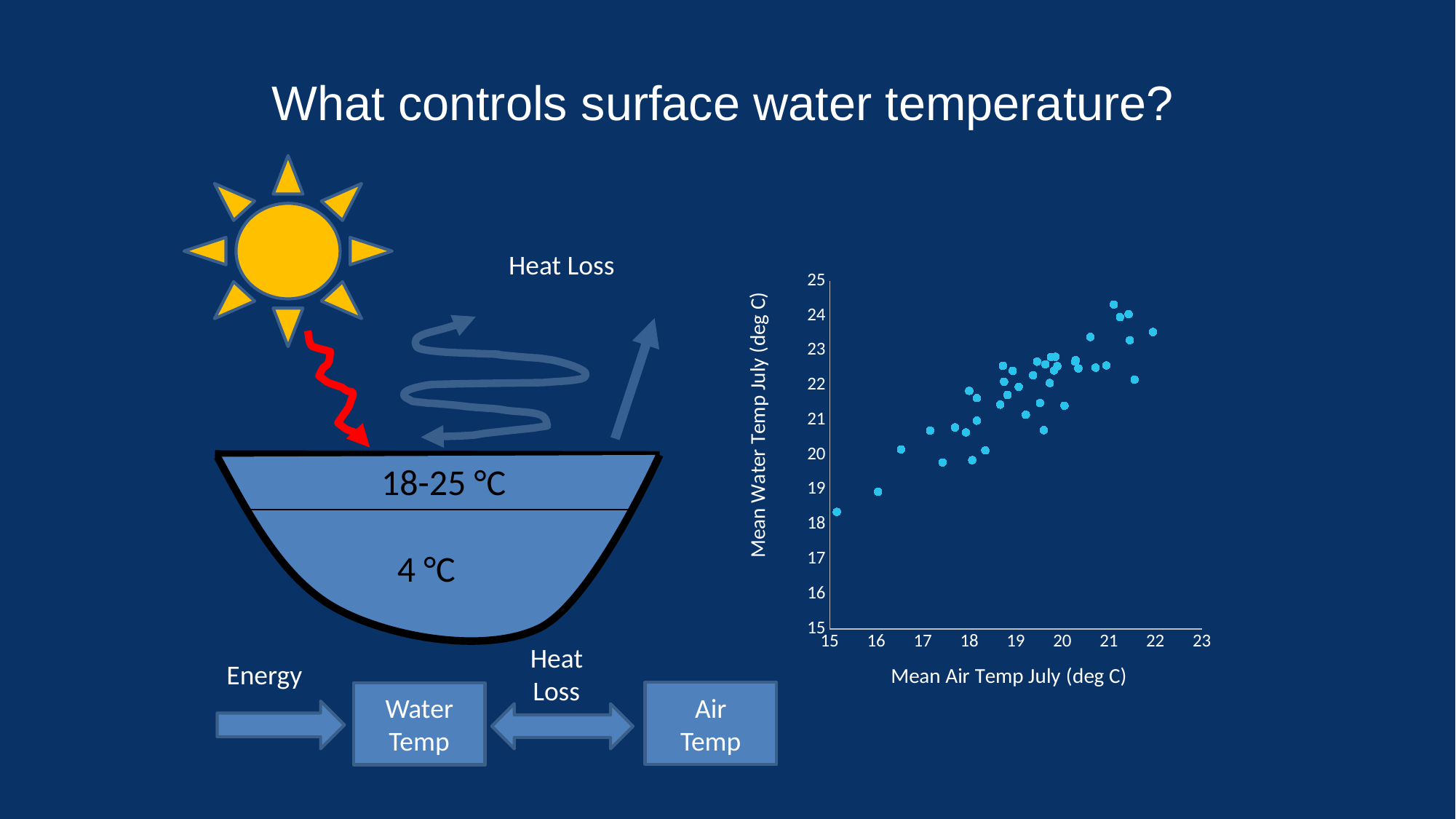
In the scatter chart, is the mean air temperature of the rightmost point greater or less than 21? greater In the scatter chart, do the mean water temperature values generally rise or fall as mean air temperature increases along the x axis? rise What kind of chart is shown on the right of the slide? scatter chart In the scatter chart, is the mean water temperature of the lowest point greater or less than 19? less In the scatter chart, is the mean water temperature of the highest point greater or less than 24? greater What is the label of the y axis of the scatter chart? Mean Water Temp July (deg C) In the scatter chart, which has the higher mean water temperature: the leftmost point or the rightmost point? the rightmost point What is the label of the x axis of the scatter chart? Mean Air Temp July (deg C)